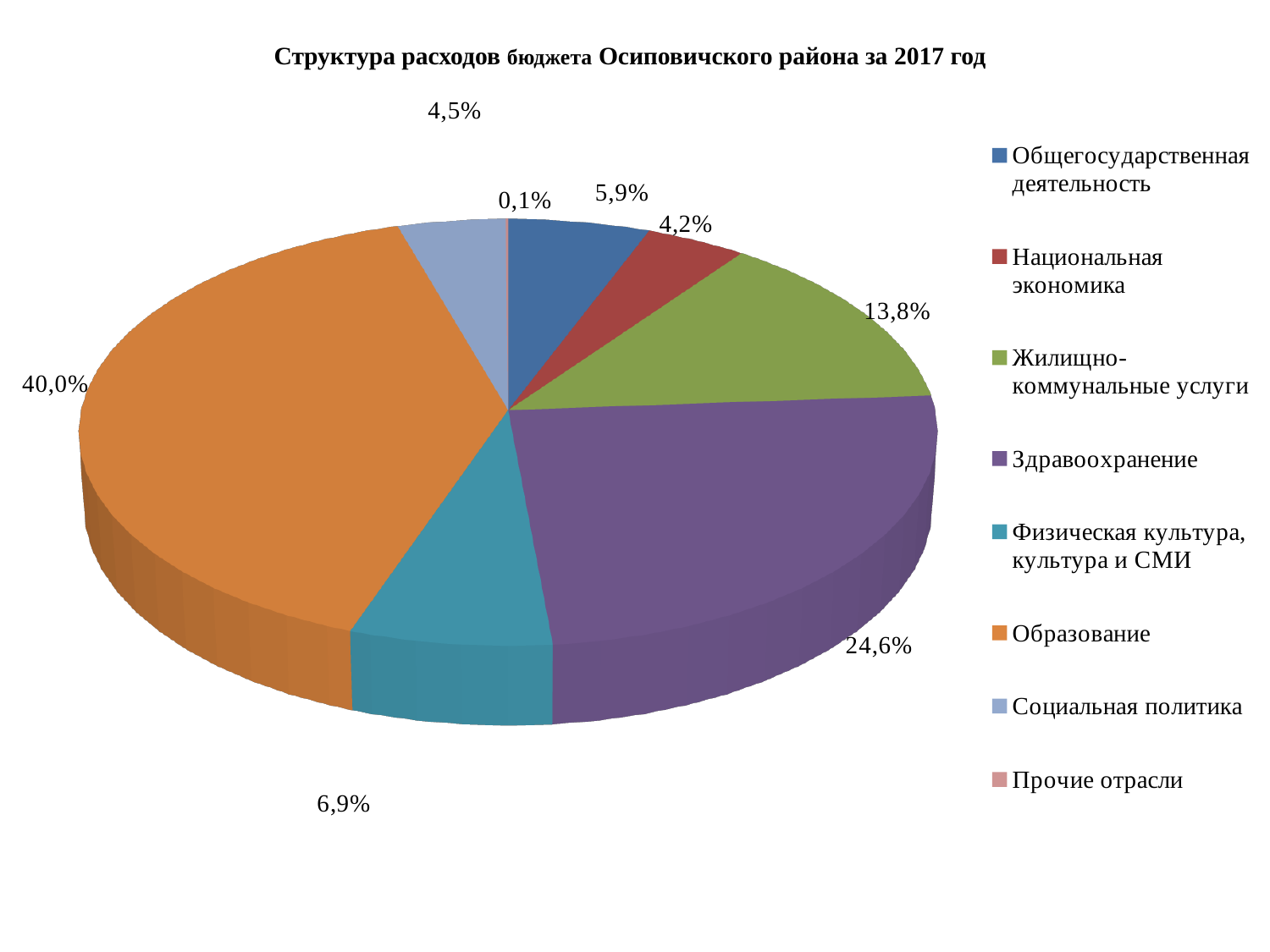
What is the title of the chart? Структура расходов бюджета Осиповичского района за 2017 год What share of the budget expenditure goes to Жилищно-коммунальные услуги? 13,8% What share of the budget expenditure goes to Здравоохранение? 24,6% Which has a larger share: Общегосударственная деятельность or Социальная политика? Общегосударственная деятельность What share of the budget expenditure goes to Прочие отрасли? 0,1% Which category has the largest share of the budget expenditure? Образование How many categories does the legend list? 8 What share of the budget expenditure goes to Физическая культура, культура и СМИ? 6,9% What share of the budget expenditure goes to Образование? 40,0% What is the difference in percentage points between the shares of Образование and Здравоохранение? 15,4 What kind of chart is shown on the slide? Pie chart Which category has the smallest share of the budget expenditure? Прочие отрасли